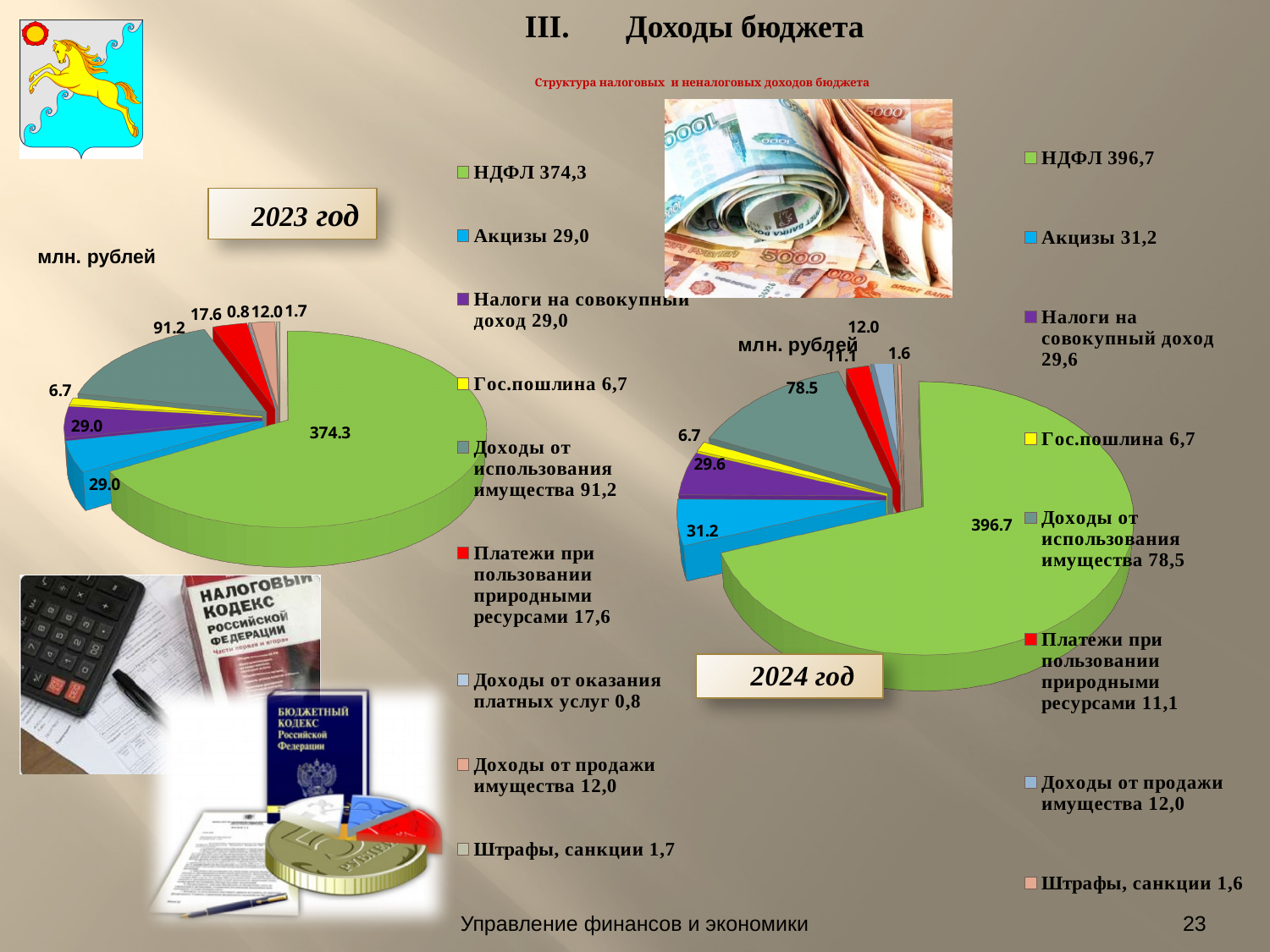
In the 2024 год pie chart, what is the value for Доходы от использования имущества? 78.5 In the 2023 год pie chart, which category has the smallest value? Доходы от оказания платных услуг In the 2024 год pie chart, what is the value for Акцизы? 31.2 What type of chart is used to show the 2024 год data? Pie chart In the 2024 год pie chart, which is larger: Акцизы or Налоги на совокупный доход? Акцизы What is the difference between the НДФЛ value in the 2024 год chart and the НДФЛ value in the 2023 год chart? 22.4 How many categories does the 2023 год pie chart show? 9 In the 2024 год pie chart, which category has the smallest value? Штрафы, санкции In the 2023 год pie chart, what is the value for НДФЛ? 374.3 In the 2023 год pie chart, what is the value for Платежи при пользовании природными ресурсами? 17.6 How many categories does the 2024 год pie chart show? 8 In the 2023 год pie chart, which category has the largest value? НДФЛ